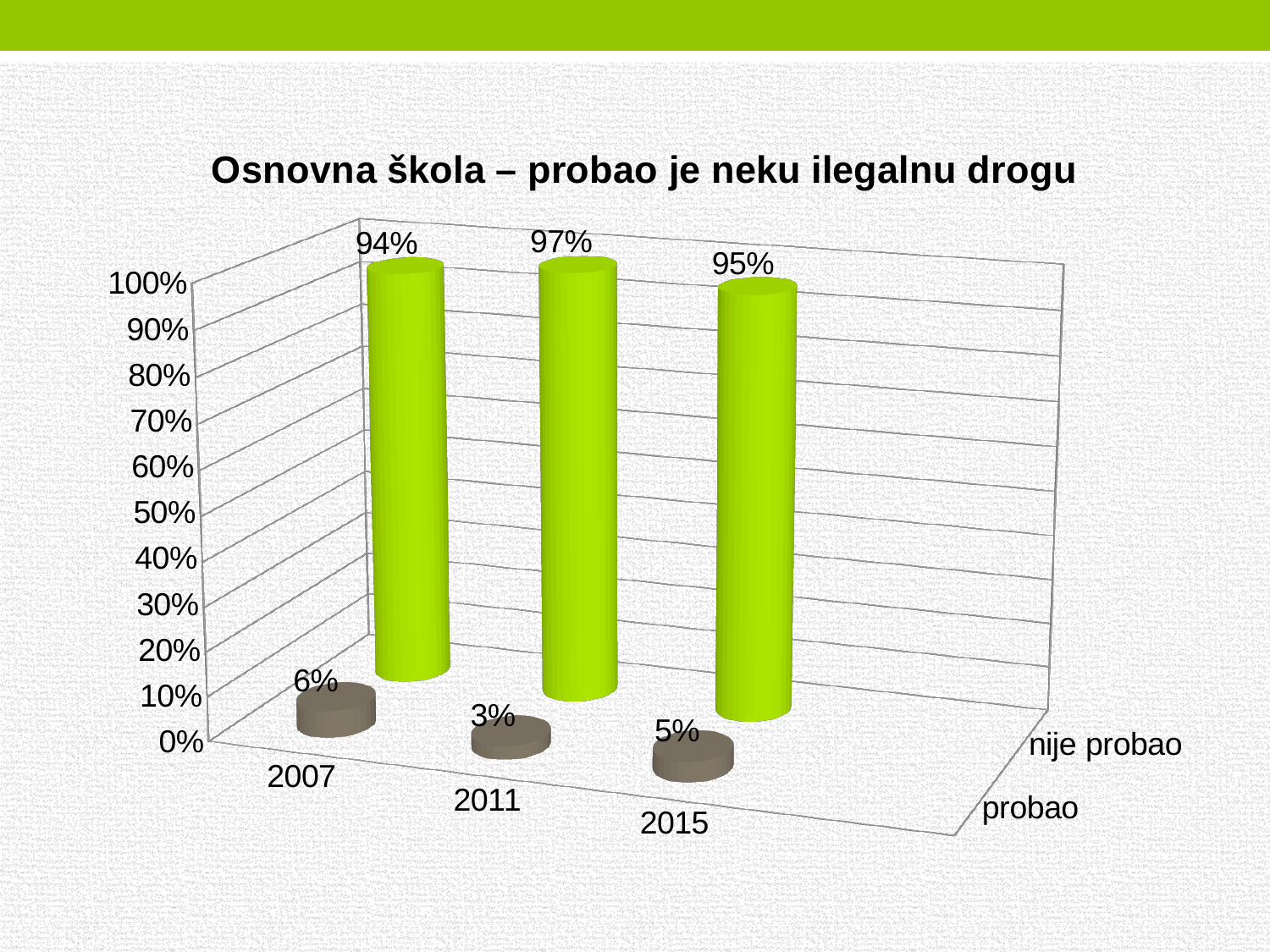
In which year is the "nije probao" value highest? 2011 What is the value for "probao" in 2007? 6% What is the value for "probao" in 2015? 5% What is the value for "nije probao" in 2011? 97% What is the title of the chart? Osnovna škola – probao je neku ilegalnu drogu Which is larger: the "nije probao" value for 2007 or for 2015? 2015 How many years are shown on the x axis? 3 How many series does the chart show? 2 What is the difference between the "probao" values for 2007 and 2011? 3% In which year is the "probao" value lowest? 2011 What kind of chart is this? bar chart What is the value for "nije probao" in 2015? 95%